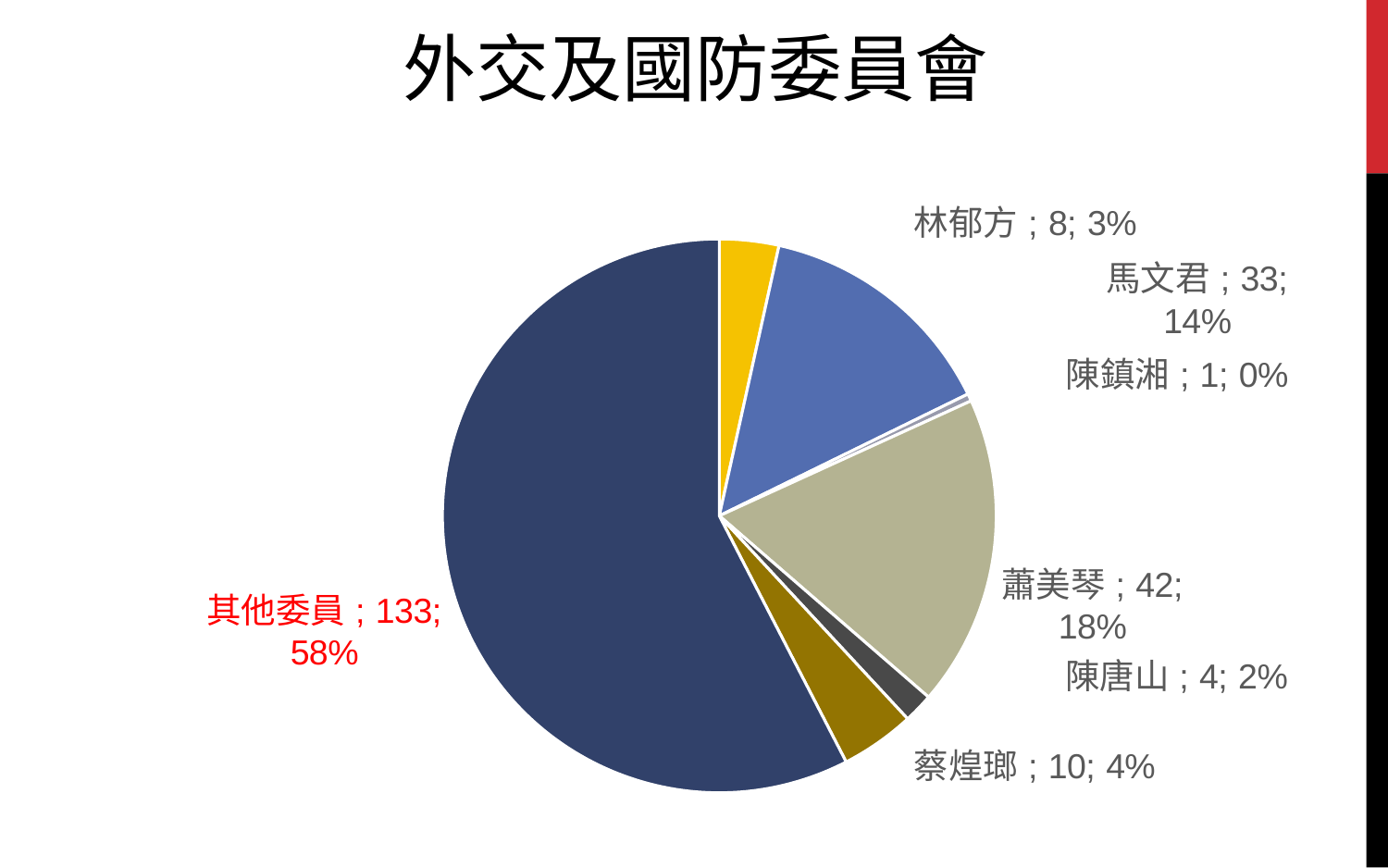
Which is larger, the value for 蔡煌瑯 or the value for 林郁方? 蔡煌瑯 What kind of chart is shown on the slide? pie chart What is the value for 馬文君? 33 Which slice is the largest? 其他委員 What is the value for 其他委員? 133 What share of the pie does 蕭美琴 represent? 18% What is the value for 蕭美琴? 42 What is the difference between the values for 蕭美琴 and 馬文君? 9 What share of the pie does 其他委員 represent? 58% How many slices does the pie chart have? 7 Which slice is the smallest? 陳鎮湘 What is the title of the chart? 外交及國防委員會